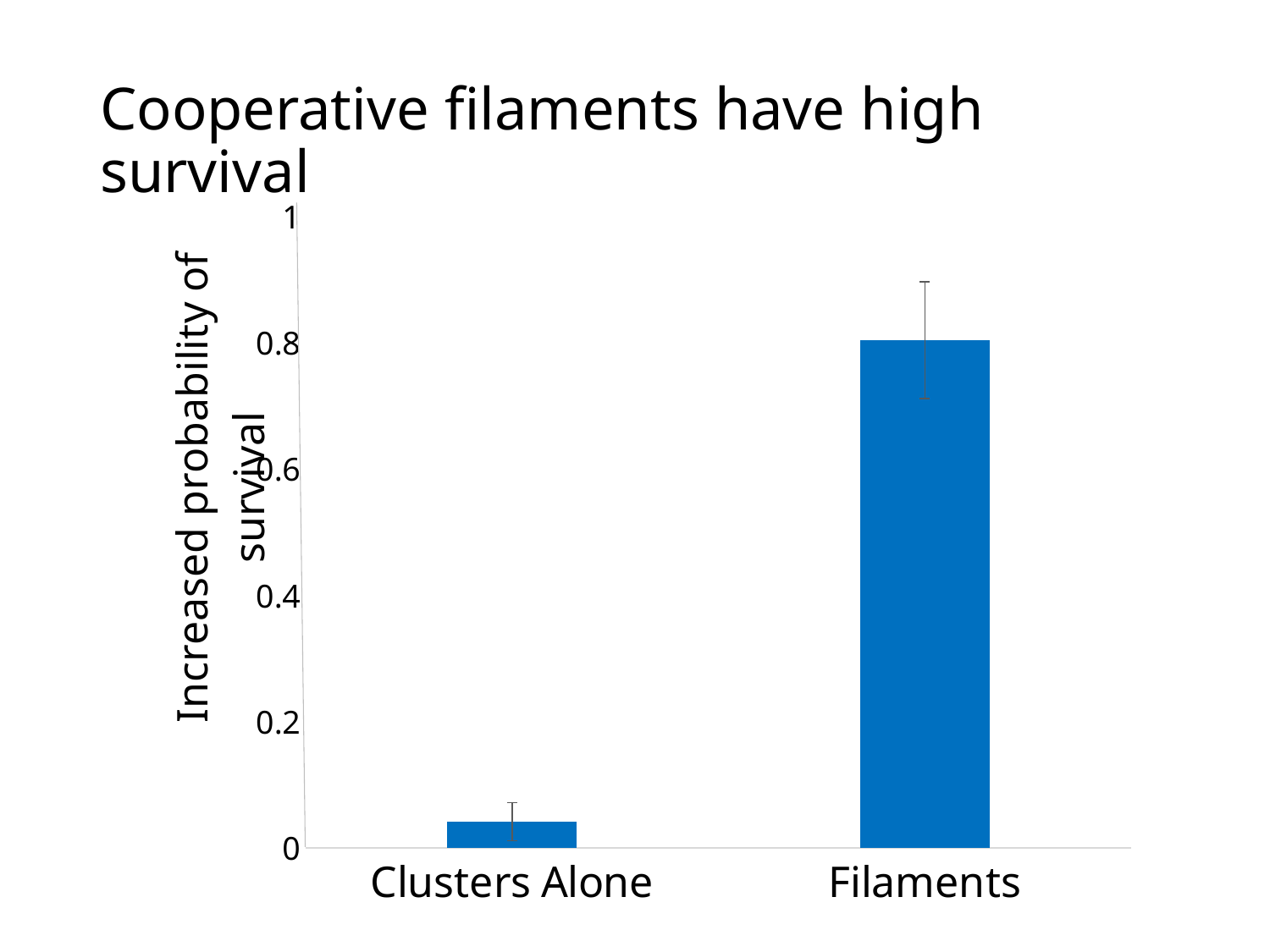
Is the value for Clusters Alone greater or less than 0.2? less How many categories are shown on the x axis of the chart? 2 Which category has the lowest increased probability of survival? Clusters Alone Is the value for Filaments greater or less than 0.6? greater What is the label on the y axis of the chart? Increased probability of survival What is the title of the slide containing the chart? Cooperative filaments have high survival Is the value for Filaments greater or less than 1? less Which has a larger increased probability of survival, Clusters Alone or Filaments? Filaments Which category has the highest increased probability of survival? Filaments What kind of chart is shown on the slide? bar chart